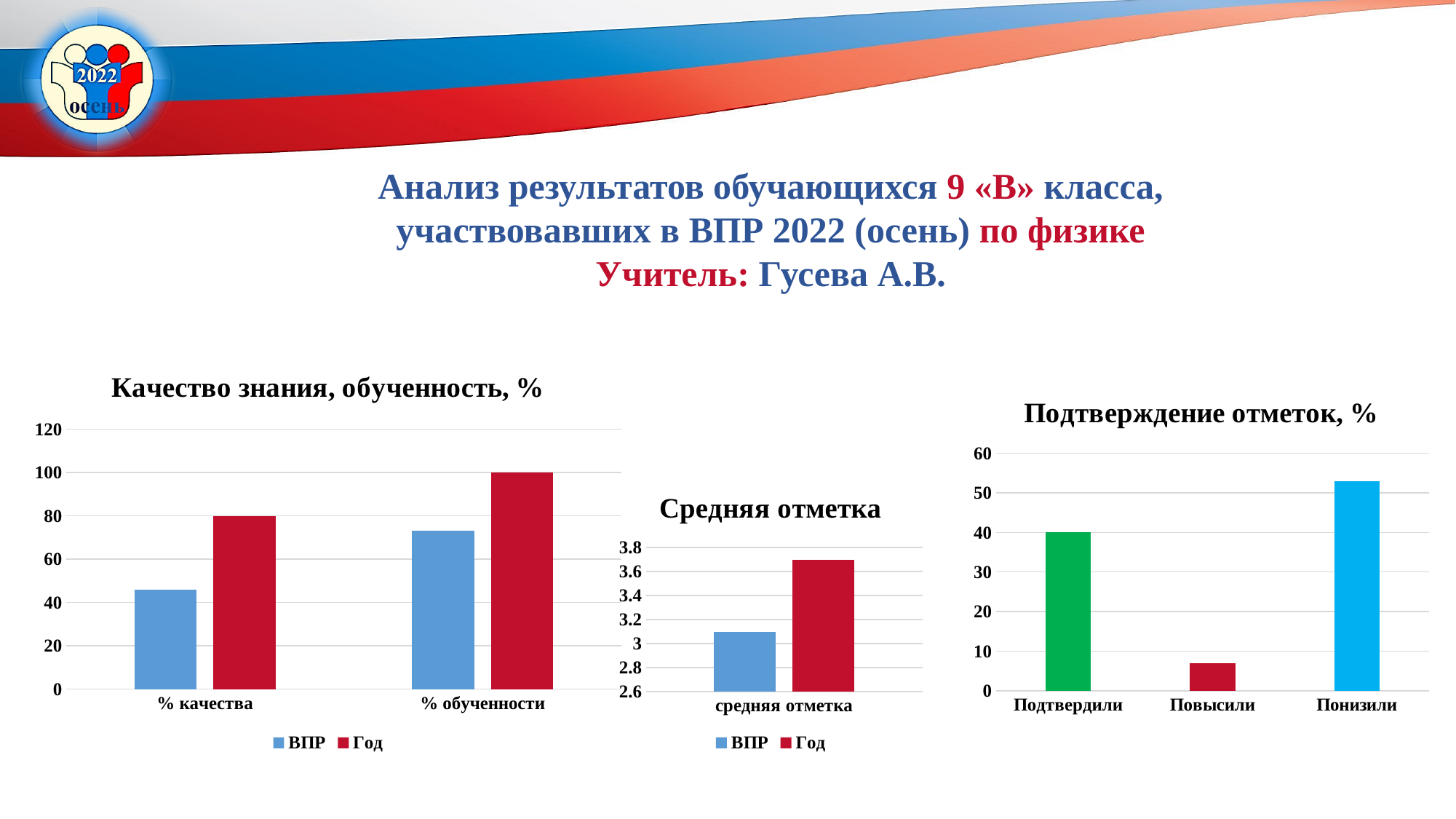
In the chart "Качество знания, обученность, %", which is larger for % обученности, ВПР or Год? Год In the chart "Качество знания, обученность, %", how many series does the legend list? 2 In the chart "Подтверждение отметок, %", which category has the lowest value? Повысили In the chart "Подтверждение отметок, %", which category has the highest value? Понизили In the chart "Качество знания, обученность, %", what is the value of Год for % обученности? 100 In the chart "Средняя отметка", is the value of ВПР greater or less than 3.4? less How many categories are shown in the chart "Подтверждение отметок, %"? 3 In the chart "Качество знания, обученность, %", is the value of ВПР for % качества greater or less than 60? less What kind of chart is "Качество знания, обученность, %"? bar chart In the chart "Средняя отметка", which series has the higher value, ВПР or Год? Год In the chart "Подтверждение отметок, %", what is the value for Подтвердили? 40 In the chart "Качество знания, обученность, %", what is the value of Год for % качества? 80